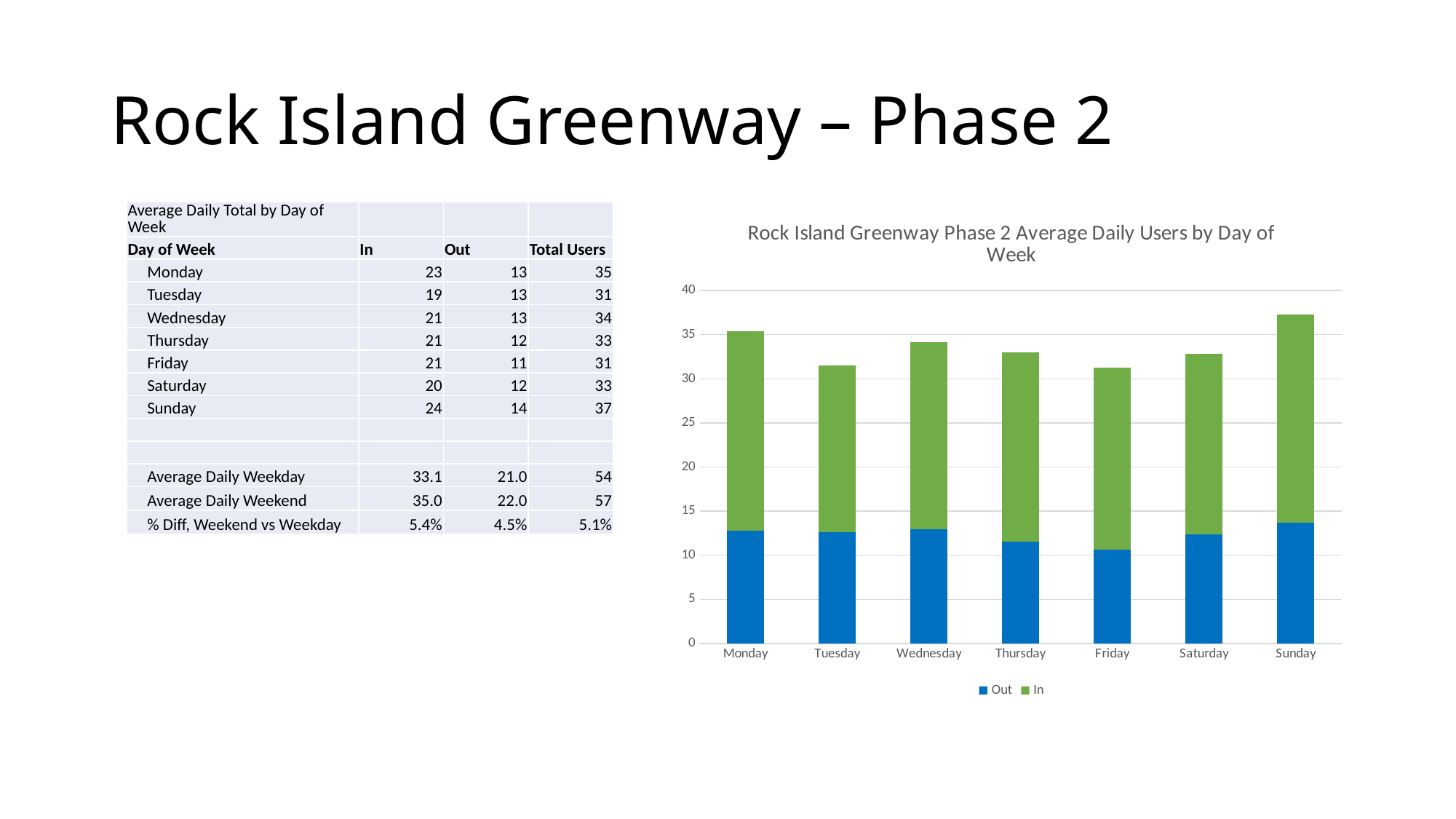
How many days of the week are plotted on the x axis of the chart? 7 Which colour represents the In series in the chart? Green Which day has the smallest Out (blue) segment in the chart? Friday What kind of chart is shown on the slide? Stacked bar chart Is the total stacked bar for Sunday greater or less than 35? greater Which stacked bar is taller, Monday or Tuesday? Monday Which day has the largest Out (blue) segment in the chart? Sunday Which day has the tallest stacked bar (highest total daily users) in the chart? Sunday Is the total stacked bar for Friday greater or less than 35? less Is the total stacked bar for Tuesday greater or less than 30? greater Which stacked bar is taller, Thursday or Friday? Thursday How many series does the chart legend list? 2